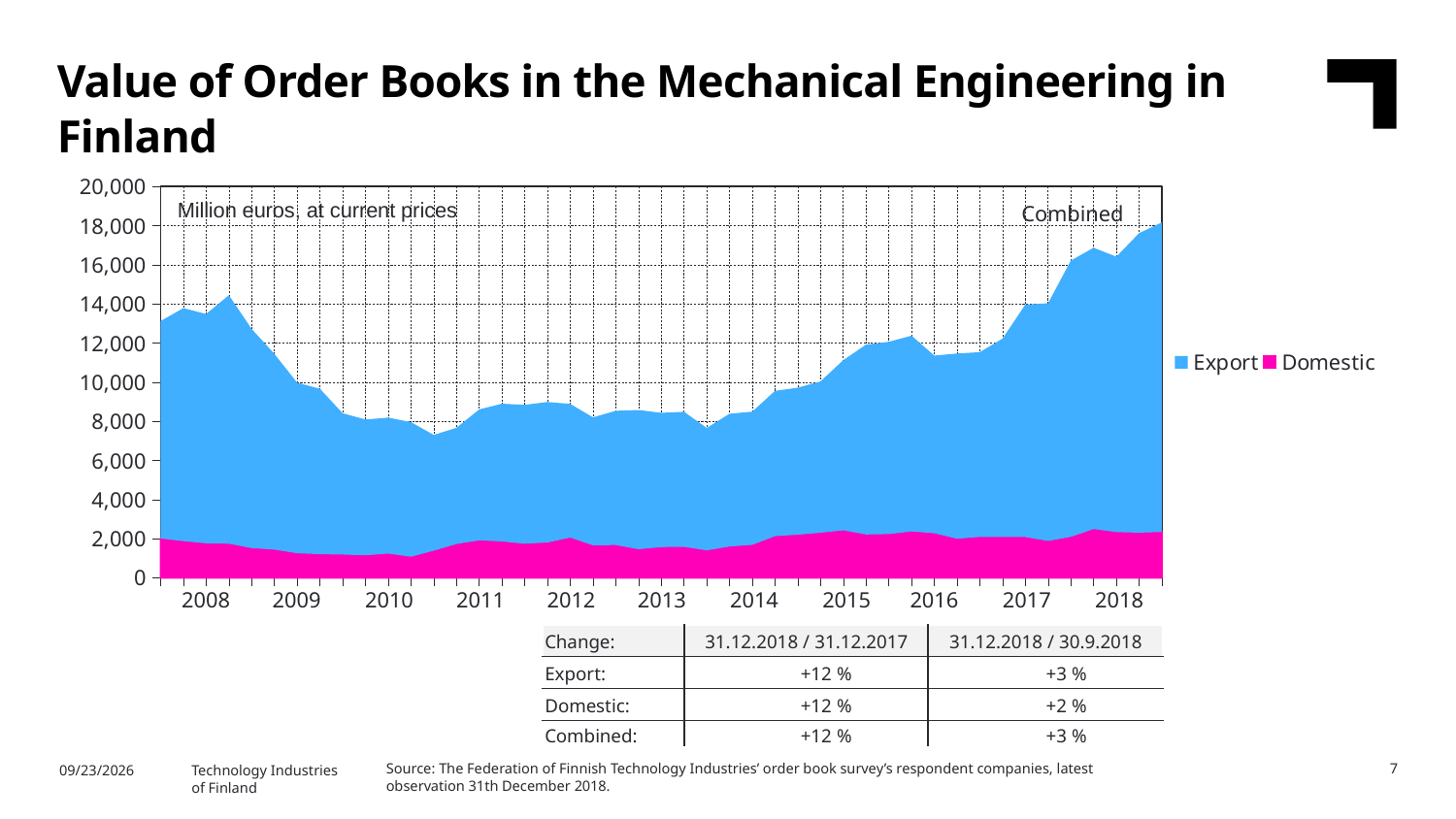
What unit is stated in the label inside the chart area? Million euros, at current prices Is the Domestic value of order books in 2010 greater or less than 2,000? less Is the combined value of order books in 2013 greater or less than 10,000? less Which two series are listed in the chart legend? Export and Domestic Does the combined value of order books rise or fall between 2008 and 2010? fall How many years are labelled on the x axis of the chart? 11 How many series does the chart legend list? 2 Does the combined value of order books rise or fall between 2016 and 2018? rise In 2018, which series is larger, Export or Domestic? Export Is the combined value of order books at the end of 2018 greater or less than 16,000? greater What kind of chart is shown on the slide? Stacked area chart